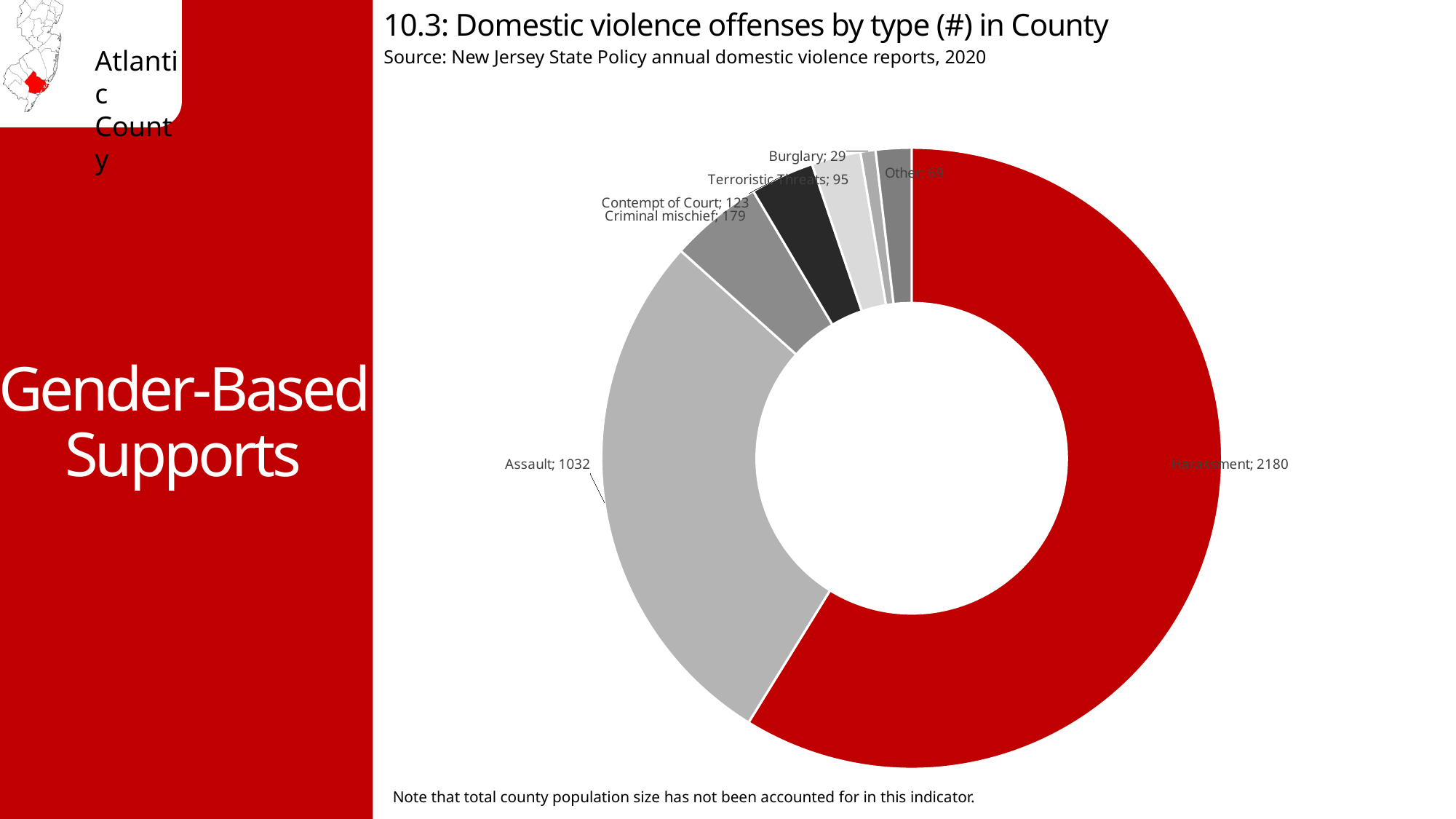
Which offense type has the largest slice in the chart? Harassment What is the value for Burglary in the chart? 29 What is the value for Terroristic Threats in the chart? 95 Which is larger, Criminal mischief or Contempt of Court? Criminal mischief What is the number of Harassment offenses shown in the chart? 2180 What is the source cited for the chart? New Jersey State Policy annual domestic violence reports, 2020 What kind of chart is shown on the slide? doughnut chart What is the number of Assault offenses shown in the chart? 1032 What is the difference between the Harassment and Assault values? 1148 Which offense type has the smallest slice in the chart? Burglary What is the value for Criminal mischief in the chart? 179 What is the value for Contempt of Court in the chart? 123